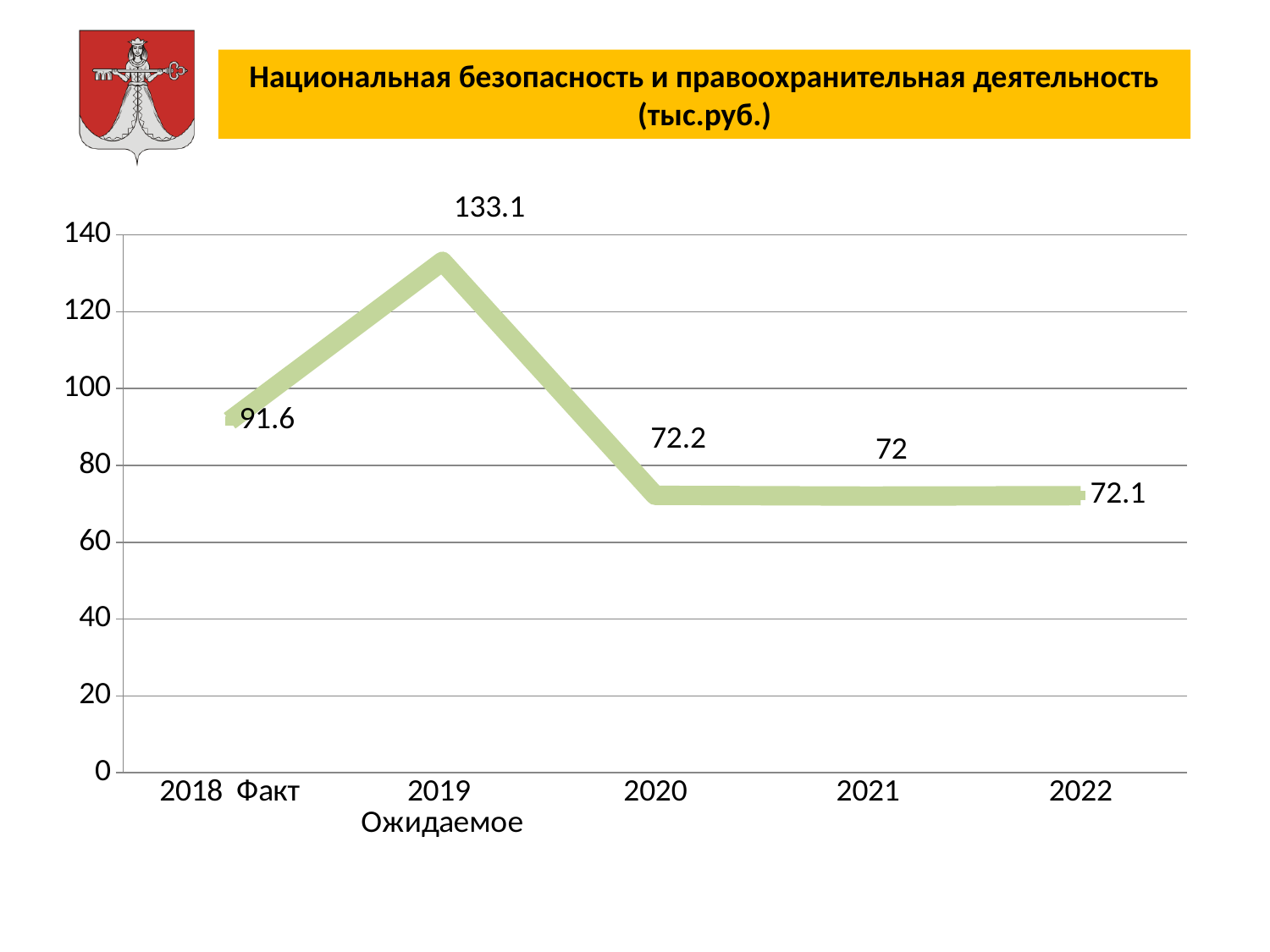
What kind of chart is shown on the slide? line chart Which is larger, the value for 2018 Факт or the value for 2020? 2018 Факт What is the value for 2019 Ожидаемое? 133.1 What is the value for 2022? 72.1 Which year has the lowest value? 2021 Is the value for 2020 greater or less than 80? less How many data points are plotted on the chart? 5 What is the value for 2018 Факт? 91.6 What is the difference between the values for 2019 Ожидаемое and 2018 Факт? 41.5 What is the title of the chart? Национальная безопасность и правоохранительная деятельность (тыс.руб.) Which year has the highest value? 2019 Ожидаемое What is the value for 2021? 72